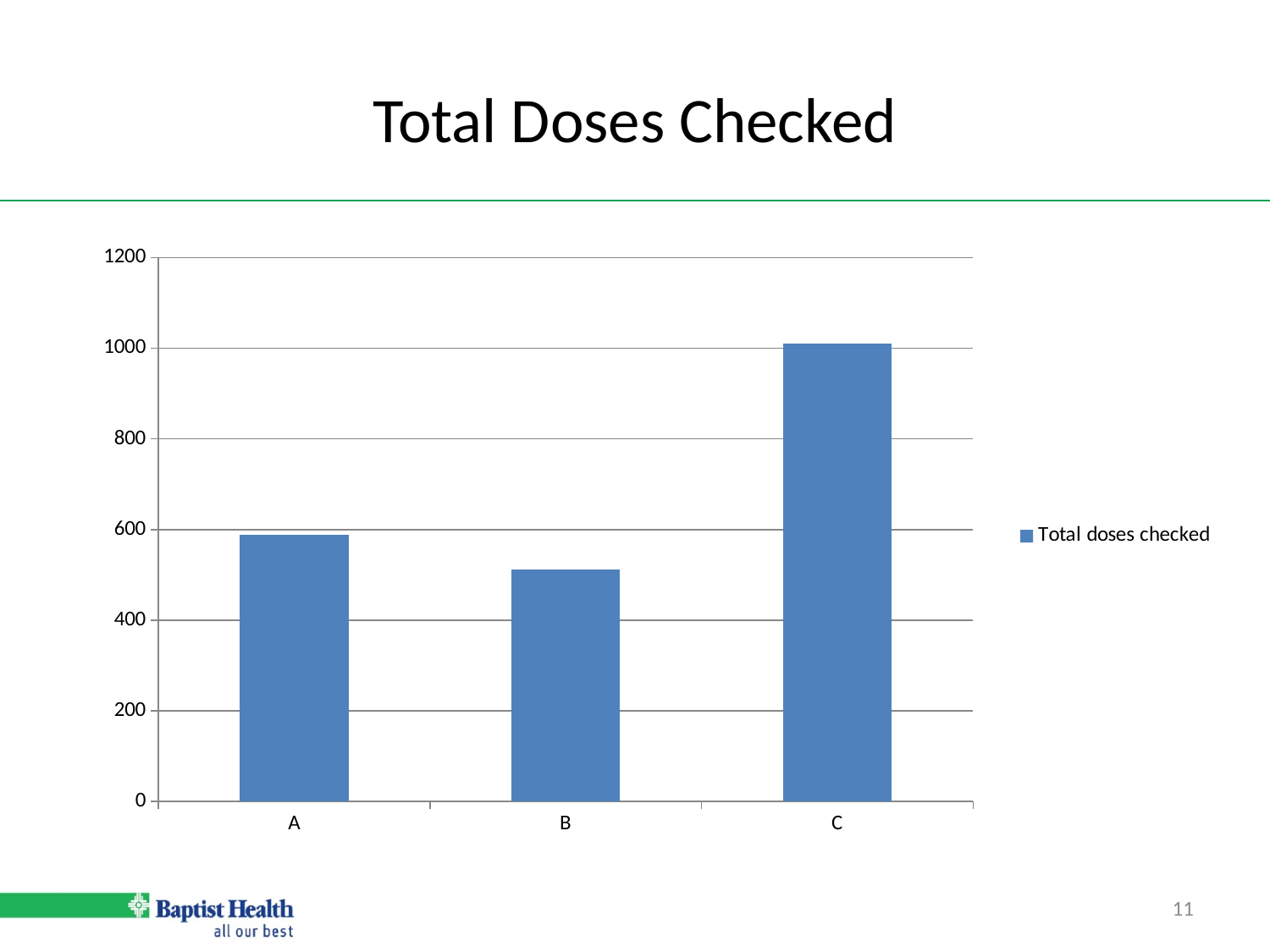
Which category has the lowest value? B Which is larger, the value for A or the value for B? A What is the title of the chart? Total Doses Checked Which is larger, the value for B or the value for C? C Is the value for C greater or less than 800? greater What kind of chart is shown on the slide? bar chart Does the value rise or fall from B to C? rise Is the value for A greater or less than 400? greater Which category has the highest value? C How many categories are shown on the x axis? 3 Is the value for B greater or less than 600? less How many series does the legend list? 1